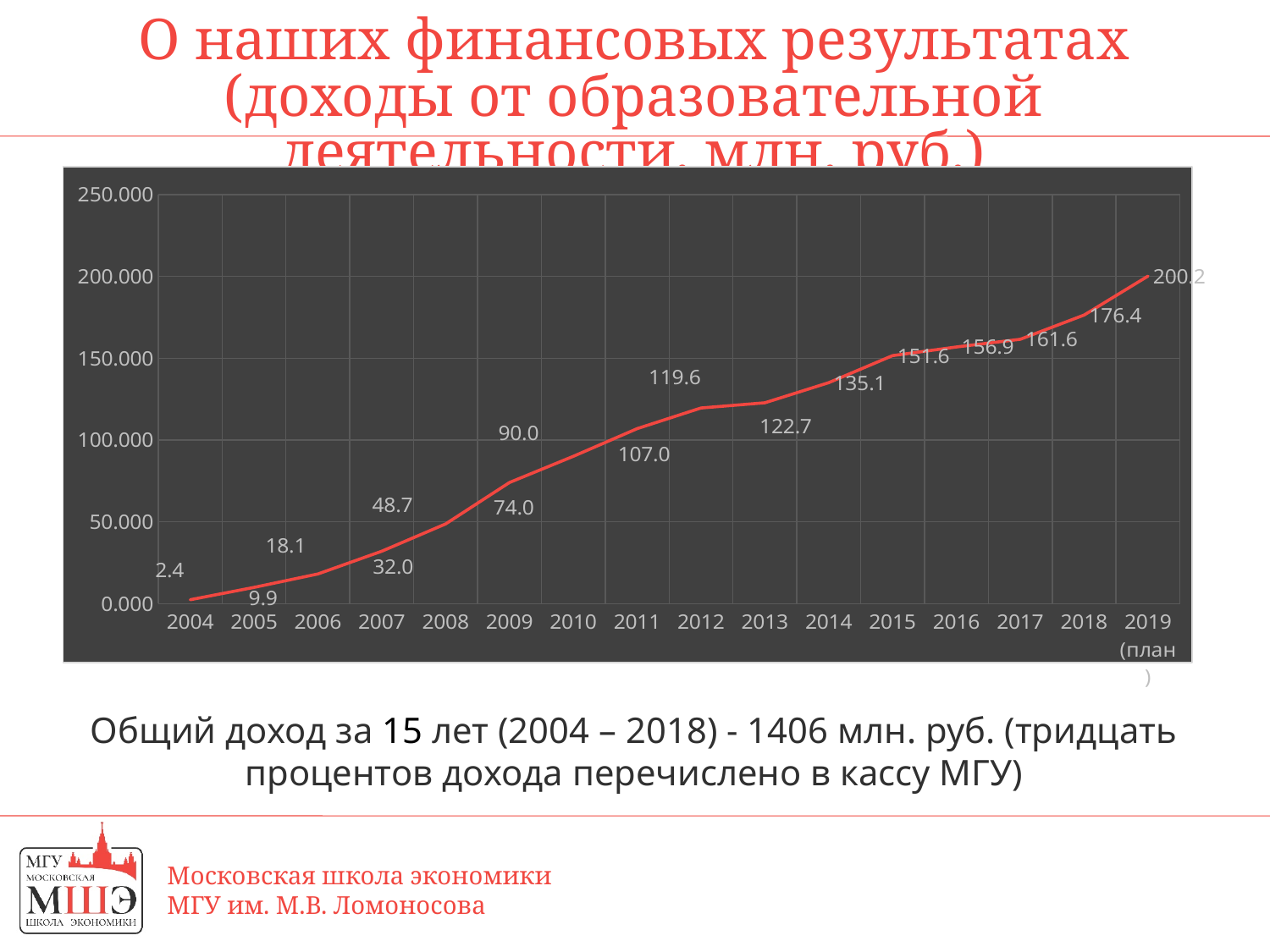
Do the values rise or fall from 2004 to 2019 (план)? rise What type of chart is shown on the slide? line chart Which is larger, the value for 2012 or the value for 2013? 2013 Which year has the lowest value on the chart? 2004 What is the value for 2013? 122.7 Which year has the highest value on the chart? 2019 (план) What is the value for 2018? 176.4 What is the difference between the values for 2018 and 2017? 14.8 What is the value for 2004? 2.4 How many data points are plotted on the chart? 16 Is the value for 2010 greater or less than 100.000? less What is the value for 2009? 74.0